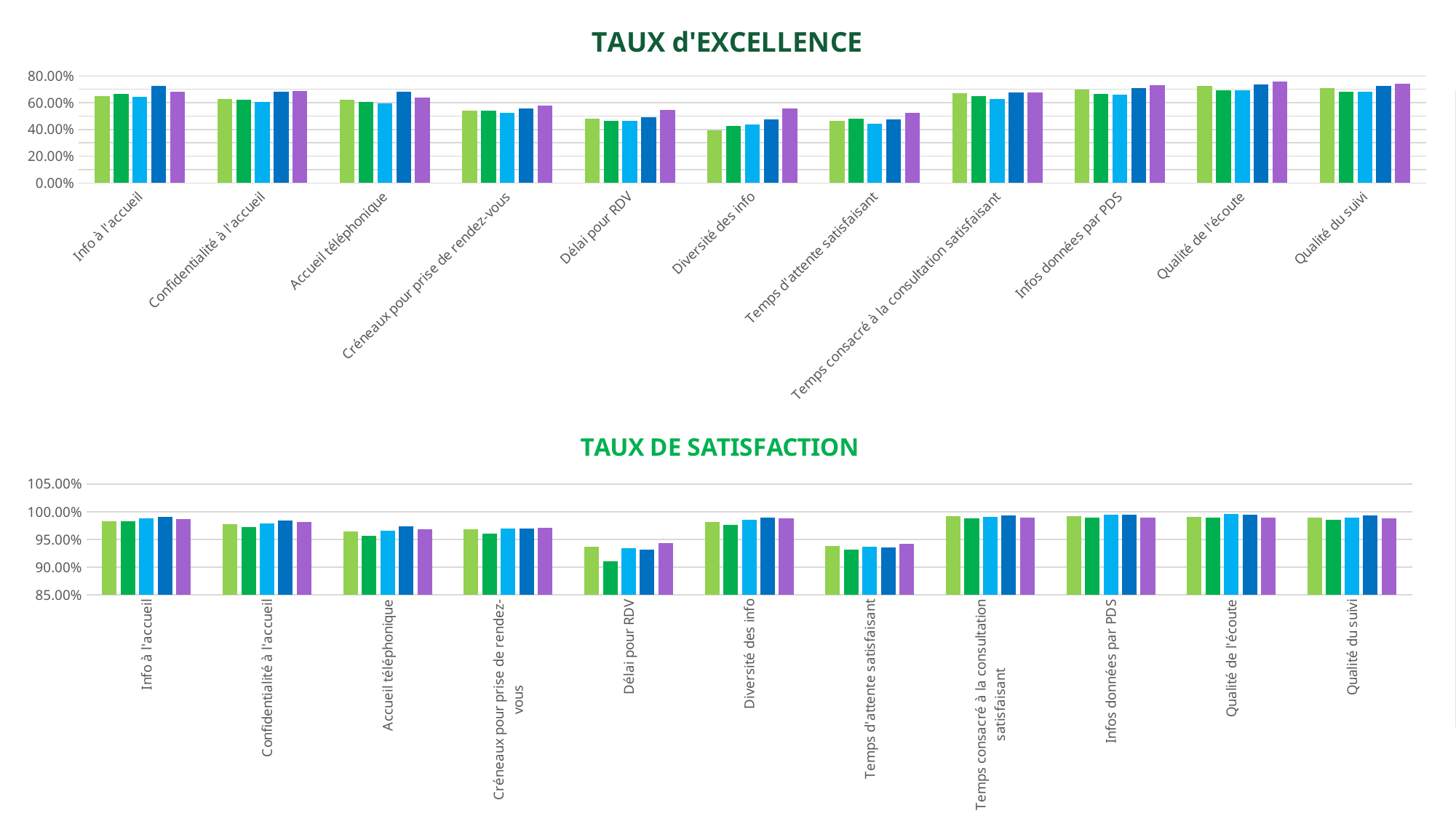
How many categories are shown on the x axis of the TAUX DE SATISFACTION chart? 11 In the TAUX DE SATISFACTION chart, which category has higher bars, Info à l'accueil or Temps d'attente satisfaisant? Info à l'accueil In the TAUX DE SATISFACTION chart, which category has the lowest bar? Délai pour RDV What kind of chart is the TAUX d'EXCELLENCE chart? bar chart How many bars are plotted for each category in the TAUX DE SATISFACTION chart? 5 How many categories are shown on the x axis of the TAUX d'EXCELLENCE chart? 11 What is the title of the top chart on the slide? TAUX d'EXCELLENCE What kind of chart is the TAUX DE SATISFACTION chart? bar chart In the TAUX DE SATISFACTION chart, is the lowest bar for Délai pour RDV greater or less than 95.00%? less In the TAUX d'EXCELLENCE chart, are the bars for Qualité de l'écoute greater or less than 60.00%? greater What is the title of the bottom chart on the slide? TAUX DE SATISFACTION In the TAUX d'EXCELLENCE chart, are the bars for Délai pour RDV greater or less than 60.00%? less